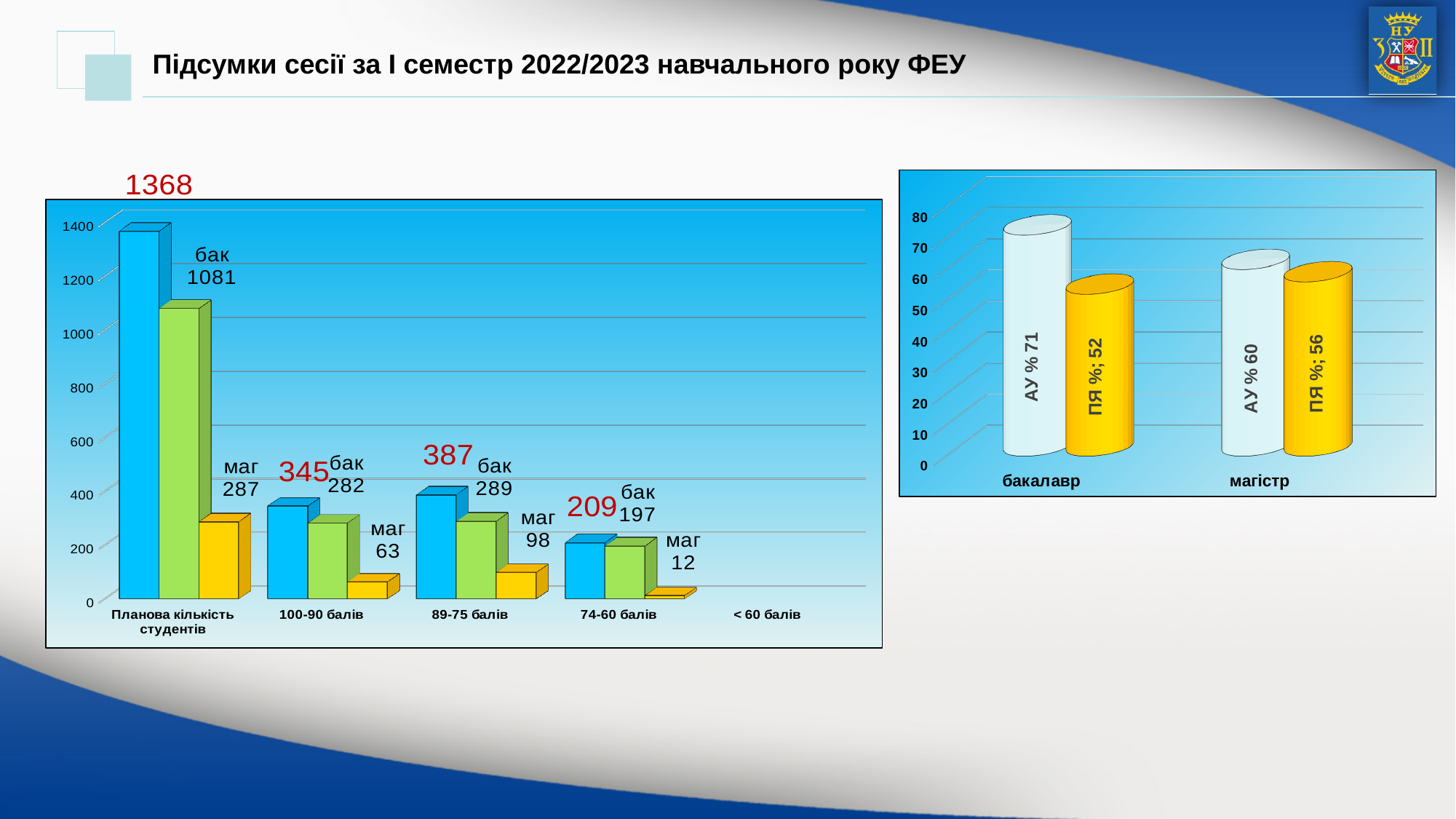
What kind of chart is the left chart? Bar chart In the left chart, what is the value labelled 'бак' for 'Планова кількість студентів'? 1081 In the left chart, what is the red total shown above the '89-75 балів' group? 387 In the left chart, is the 'маг' value for '89-75 балів' larger than the 'маг' value for '100-90 балів'? Yes In the left chart, what is the difference between the 'бак' values for '89-75 балів' and '100-90 балів'? 7 In the left chart, which score category has the lowest red total: '100-90 балів', '89-75 балів' or '74-60 балів'? 74-60 балів In the right chart, what is the difference between the 'АУ %' values for 'бакалавр' and 'магістр'? 11 In the right chart, what is the 'ПЯ %' value for 'магістр'? 56 In the left chart, what is the value labelled 'маг' for '74-60 балів'? 12 In the right chart, what is the 'АУ %' value for 'бакалавр'? 71 In the left chart, how many categories are labelled on the x axis? 5 In the left chart, what is the value labelled 'маг' for '100-90 балів'? 63